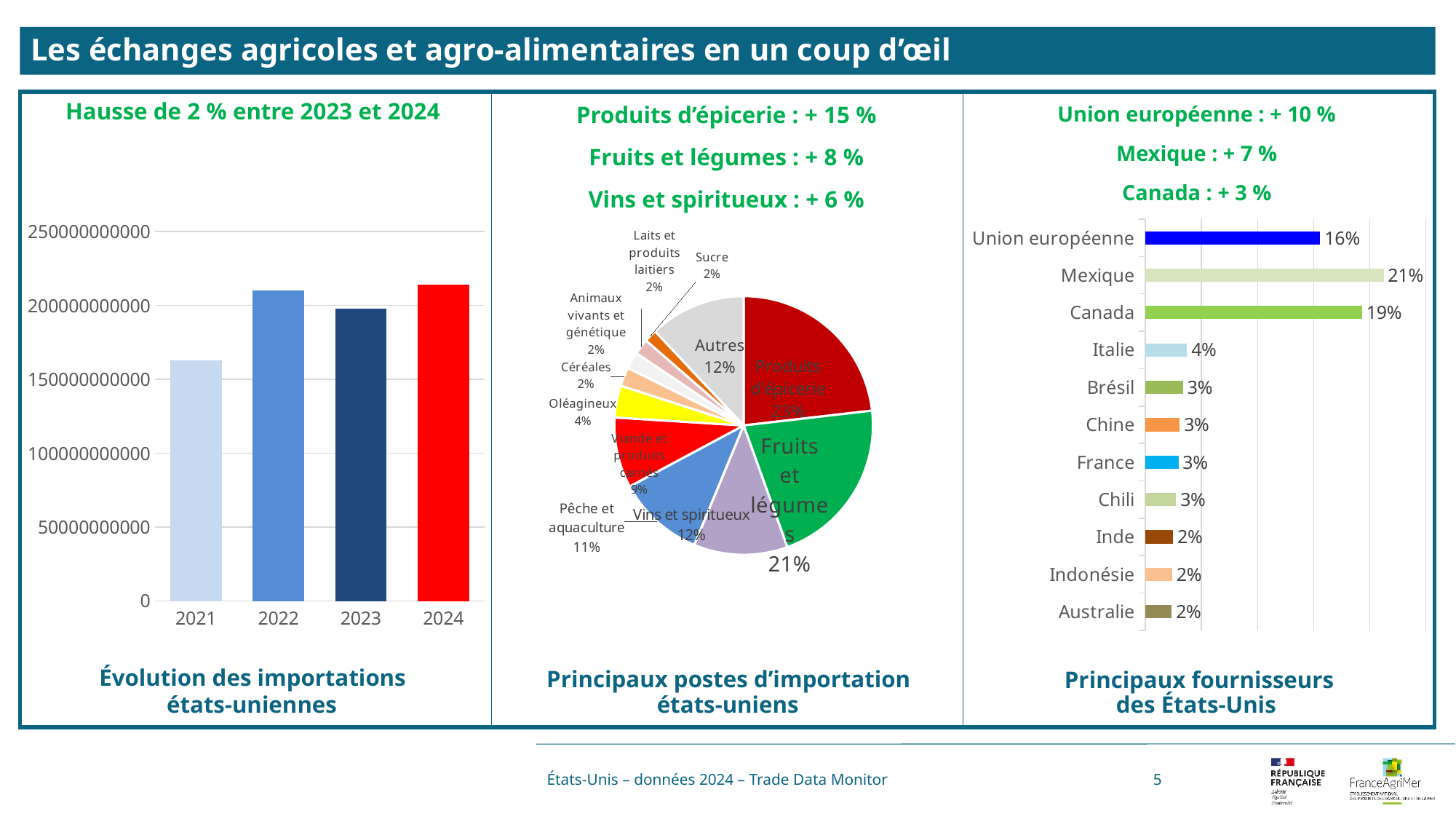
In the chart 'Évolution des importations états-uniennes', which year has the lowest value? 2021 In the chart 'Principaux fournisseurs des États-Unis', what is the value for Italie? 4% In the chart 'Évolution des importations états-uniennes', is the value for 2021 greater or less than 200000000000? less In the chart 'Principaux fournisseurs des États-Unis', what is the value for Mexique? 21% In the pie chart 'Principaux postes d'importation états-uniens', which is larger: Vins et spiritueux or Pêche et aquaculture? Vins et spiritueux In the pie chart 'Principaux postes d'importation états-uniens', what share does Viande et produits carnés represent? 9% In the chart 'Principaux fournisseurs des États-Unis', what is the difference between the values for Canada and Union européenne? 3% In the chart 'Évolution des importations états-uniennes', is the value for 2022 greater or less than 200000000000? greater What kind of chart is 'Évolution des importations états-uniennes'? bar chart In the pie chart 'Principaux postes d'importation états-uniens', what share does Produits d'épicerie represent? 23% In the chart 'Principaux fournisseurs des États-Unis', which supplier has the highest share? Mexique In the chart 'Principaux fournisseurs des États-Unis', how many suppliers are listed? 11